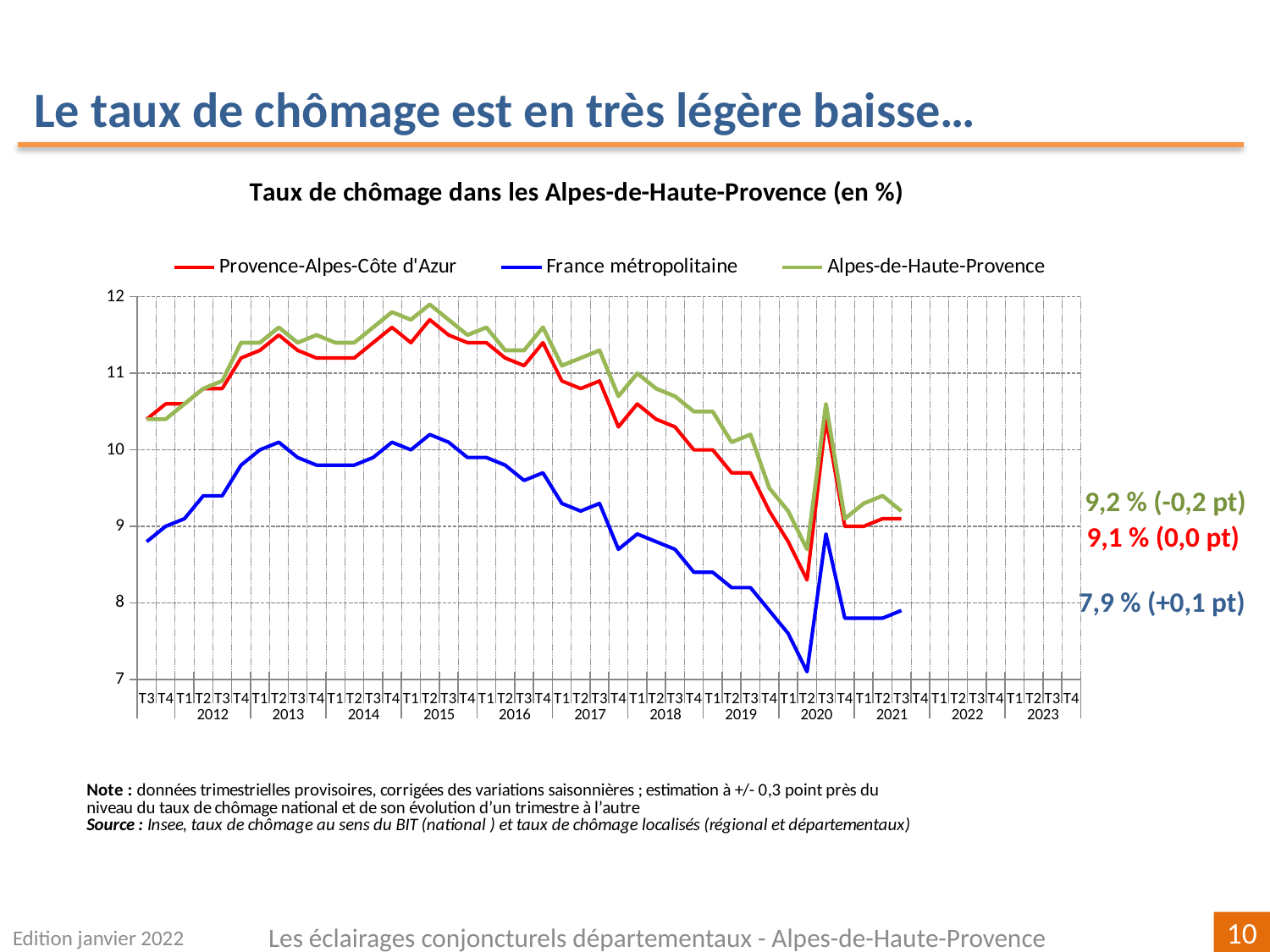
At the latest point, which is higher: Alpes-de-Haute-Provence or France métropolitaine? Alpes-de-Haute-Provence What type of chart is shown on the slide? line chart What is the latest unemployment rate shown for France métropolitaine? 7,9 % Is the value for France métropolitaine in T1 2020 greater or less than 8? less What quarterly change is indicated for the latest Alpes-de-Haute-Provence value? -0,2 pt How many series does the legend of the chart list? 3 What is the difference between the latest values for Alpes-de-Haute-Provence (9,2 %) and France métropolitaine (7,9 %)? 1,3 points What is the latest unemployment rate shown for Provence-Alpes-Côte d'Azur? 9,1 % Is the value for Alpes-de-Haute-Provence in T2 2015 greater or less than 11? greater What is the latest unemployment rate shown for Alpes-de-Haute-Provence? 9,2 % What is the title of the chart? Taux de chômage dans les Alpes-de-Haute-Provence (en %) Which series has the lowest values across the whole period? France métropolitaine